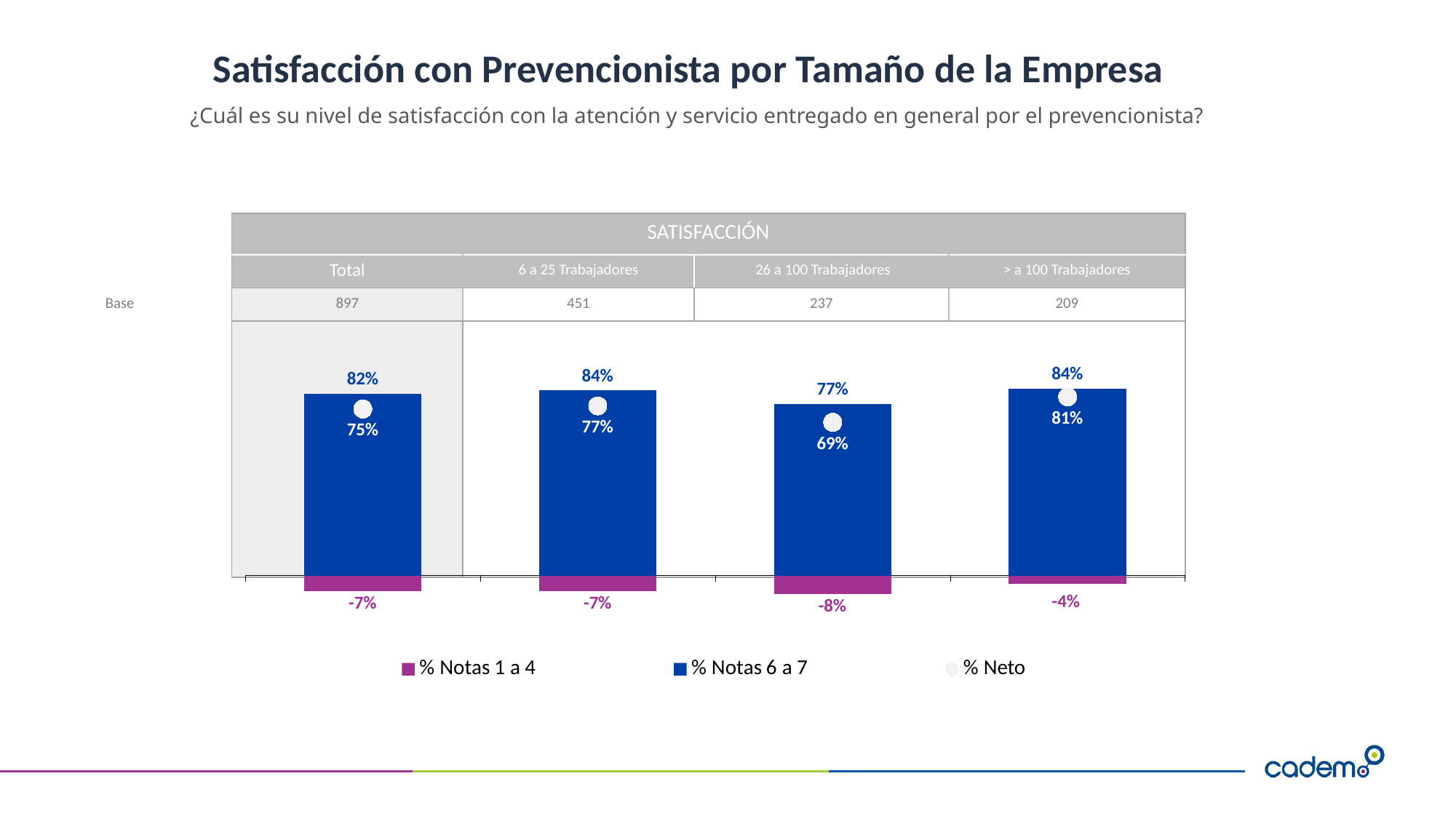
Which category has the lowest % Neto value? 26 a 100 Trabajadores What is the % Notas 1 a 4 value for 26 a 100 Trabajadores? -8% Which is larger, the % Neto value for Total or for > a 100 Trabajadores? > a 100 Trabajadores What is the base (number of respondents) for 6 a 25 Trabajadores? 451 What is the % Neto value for > a 100 Trabajadores? 81% What is the difference between the % Notas 6 a 7 values for 6 a 25 Trabajadores and 26 a 100 Trabajadores? 7% What is the % Notas 6 a 7 value for Total? 82% Which category has the lowest % Notas 6 a 7 value? 26 a 100 Trabajadores How many categories are shown on the x axis of the chart? 4 How many series does the legend list? 3 What kind of chart is shown on the slide? Bar chart What is the % Neto value for 6 a 25 Trabajadores? 77%